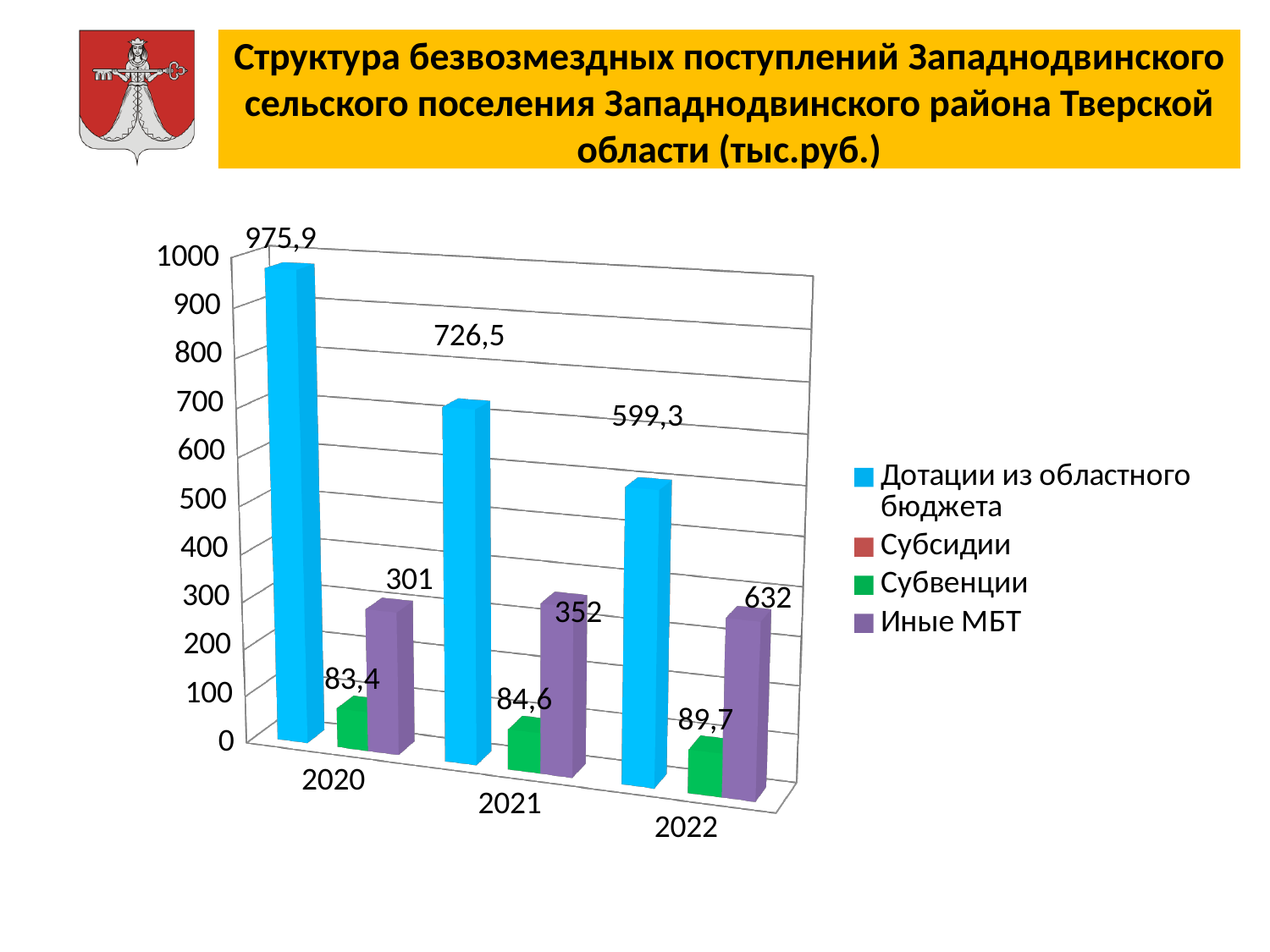
What is the difference between the Дотации из областного бюджета values for 2020 and 2021? 249,4 What is the value for Дотации из областного бюджета in 2022? 599,3 How many series does the legend list? 4 Do the values for Дотации из областного бюджета rise or fall from 2020 to 2022? fall What is the value for Субвенции in 2021? 84,6 In which year is the value for Субвенции the lowest? 2020 Which year has the larger value for Иные МБТ, 2020 or 2021? 2021 What kind of chart is shown on the slide? bar chart In which year is the value for Дотации из областного бюджета the highest? 2020 What is the value for Дотации из областного бюджета in 2020? 975,9 How many years are shown on the x axis? 3